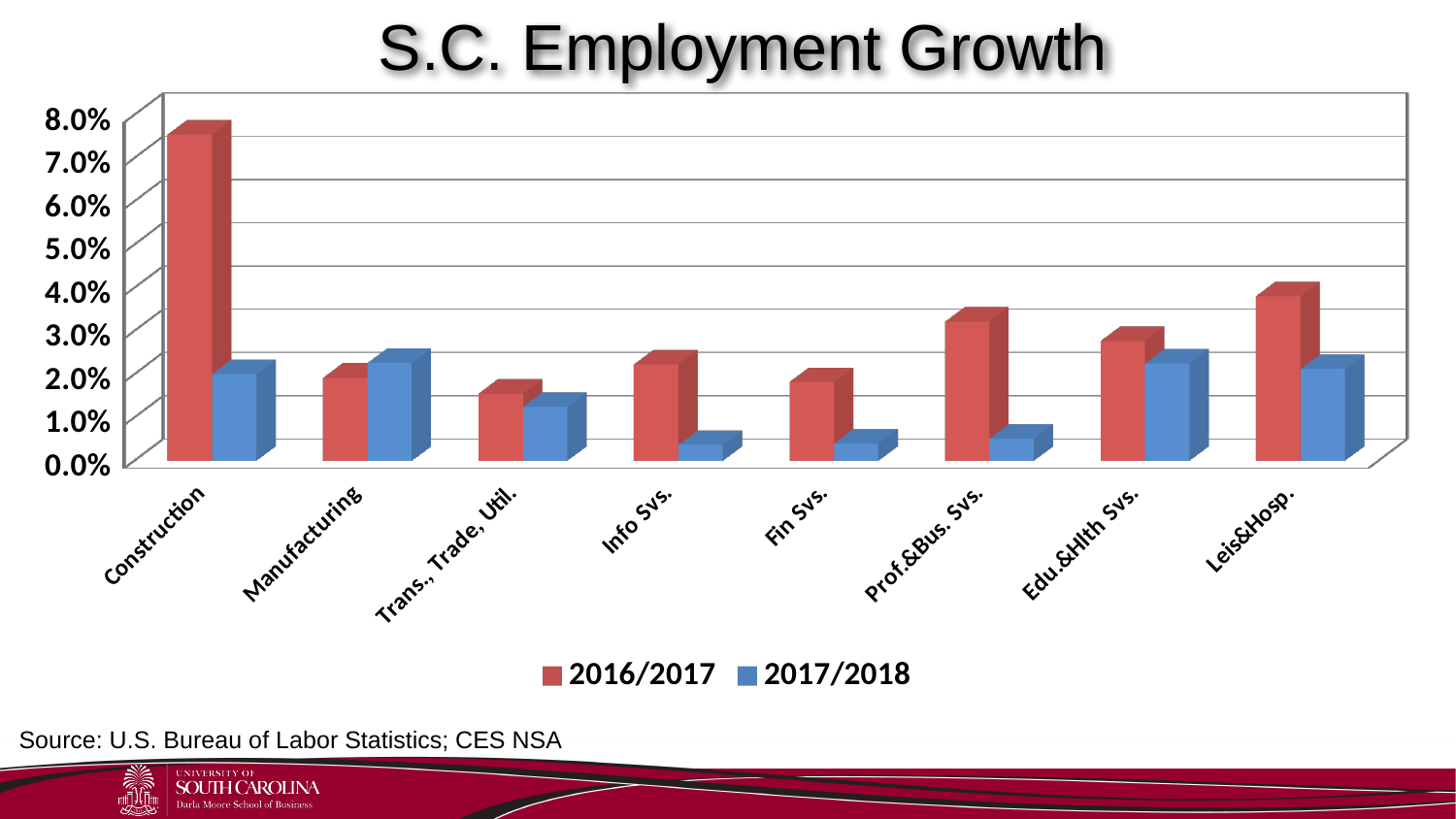
For Manufacturing, which series has the larger value, 2016/2017 or 2017/2018? 2017/2018 Is the 2016/2017 value for Leis&Hosp. greater or less than 3.0%? greater Is the 2017/2018 value for Info Svs. greater or less than 1.0%? less What are the two series named in the legend? 2016/2017 and 2017/2018 How many industry categories are shown on the x axis? 8 For Prof.&Bus. Svs., which series has the larger value, 2016/2017 or 2017/2018? 2016/2017 Is the 2017/2018 value for Fin Svs. greater or less than 1.0%? less How many series does the legend list? 2 Which category has the highest 2016/2017 value? Construction What is the title of the chart? S.C. Employment Growth What kind of chart is shown on the slide? bar chart